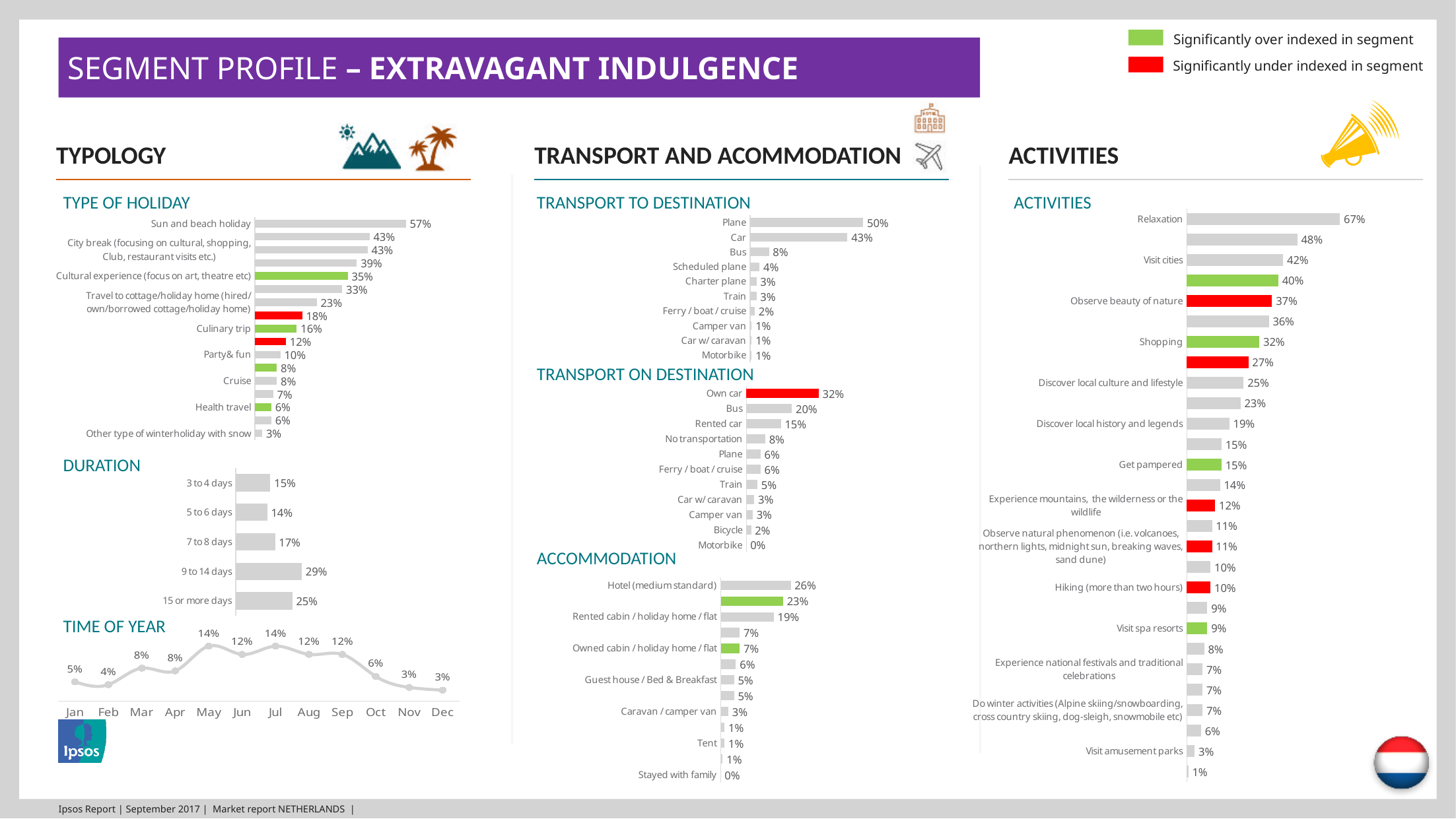
In the Transport on Destination chart, which category has the highest value? Own car In the Activities chart, what is the value for Relaxation? 67% In the Type of Holiday chart, what is the value for Culinary trip? 16% What kind of chart is the Time of Year chart? Line chart In the Type of Holiday chart, what is the value for Sun and beach holiday? 57% In the Duration chart, what is the difference between 9 to 14 days and 15 or more days? 4% In the Time of Year chart, how many months are plotted? 12 In the Transport to Destination chart, what is the value for Plane? 50% In the Time of Year chart, what is the value for Feb? 4% In the Transport on Destination chart, which is larger, Bus or Rented car? Bus In the Accommodation chart, what is the value for Hotel (medium standard)? 26% In the Duration chart, which category has the highest value? 9 to 14 days